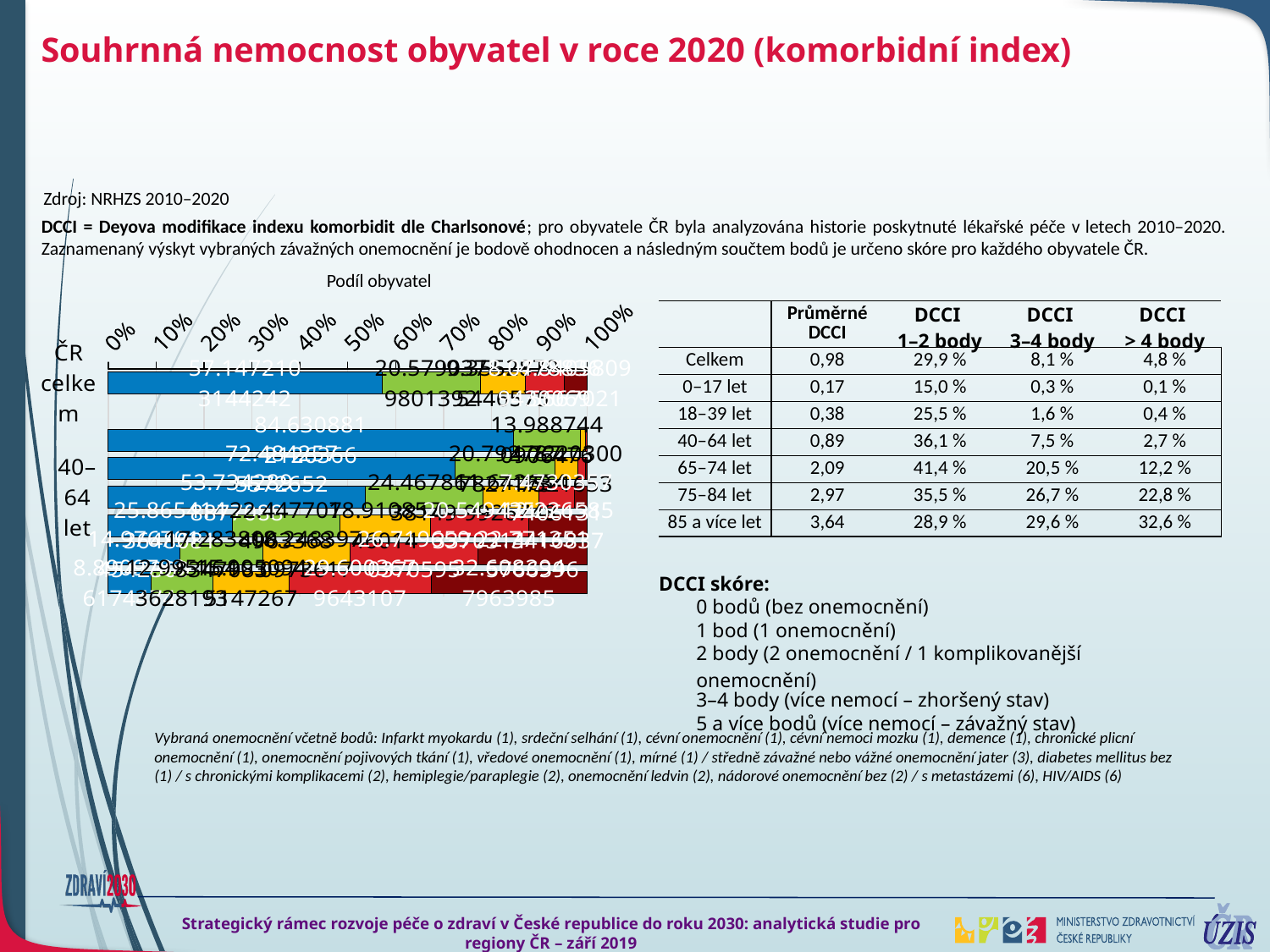
What is the title printed above the chart's horizontal axis? Podíl obyvatel What kind of chart is shown on the left of the slide? bar chart Is the blue segment of the ČR celkem bar greater or less than 70%? less Is the blue segment of the ČR celkem bar greater or less than 50%? greater What is the highest value shown on the chart's horizontal axis? 100%